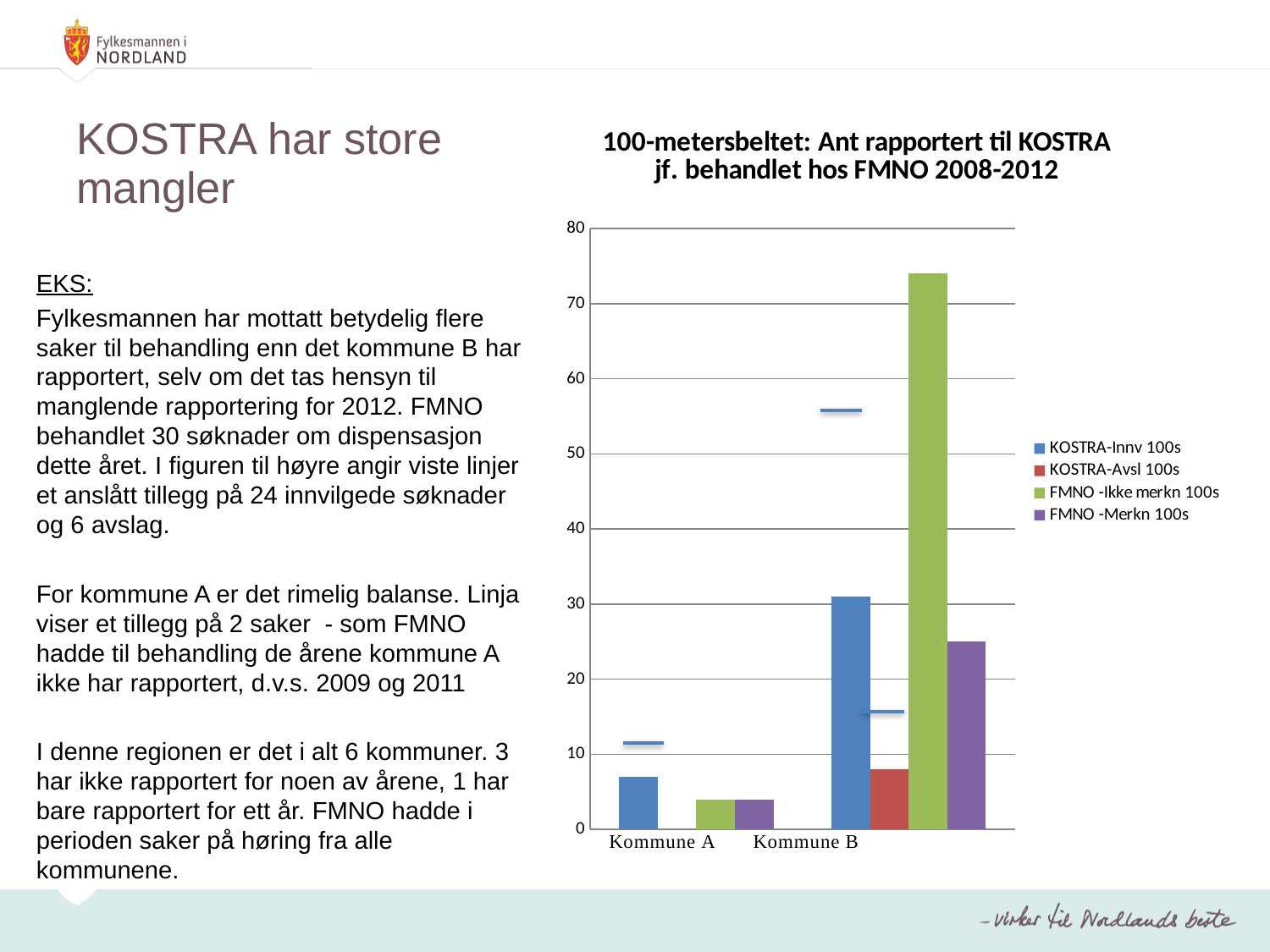
Is the value of FMNO -Merkn 100s for Kommune B greater or less than 30? less Is the value of FMNO -Ikke merkn 100s for Kommune B greater or less than 70? greater Is the value of KOSTRA-Avsl 100s for Kommune B greater or less than 10? less How many categories (kommuner) are shown on the x axis of the chart? 2 Which series has the highest bar for Kommune B? FMNO -Ikke merkn 100s How many series does the chart legend list? 4 Which series has the lowest bar for Kommune B? KOSTRA-Avsl 100s What kind of chart is shown on the slide? bar chart What is the title of the chart? 100-metersbeltet: Ant rapportert til KOSTRA jf. behandlet hos FMNO 2008-2012 For Kommune B, which is larger: KOSTRA-Innv 100s or FMNO -Merkn 100s? KOSTRA-Innv 100s Which kommune has the higher value for KOSTRA-Innv 100s? Kommune B